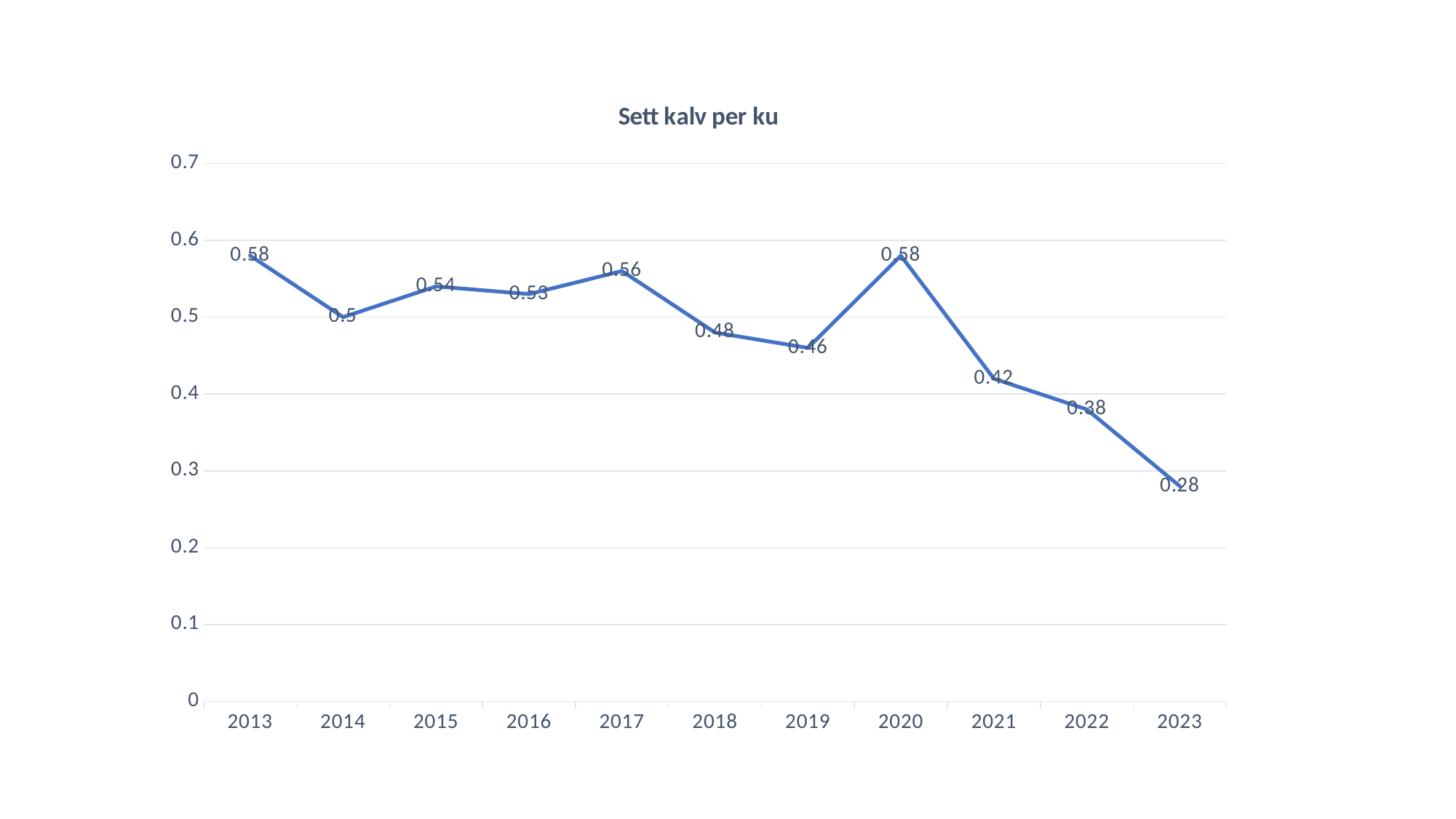
What is the difference between the values for 2013 and 2023? 0.3 What is the value for 2023? 0.28 How many years are plotted on the x axis? 11 What is the difference between the values for 2020 and 2021? 0.16 What is the title of the chart? Sett kalv per ku Which is larger, the value for 2017 or the value for 2018? 2017 What is the value for 2019? 0.46 Is the value for 2022 greater or less than 0.4? less Which year has the lowest value? 2023 Do the values generally rise or fall from 2020 to 2023? fall What is the value for 2013? 0.58 What kind of chart is this? line chart